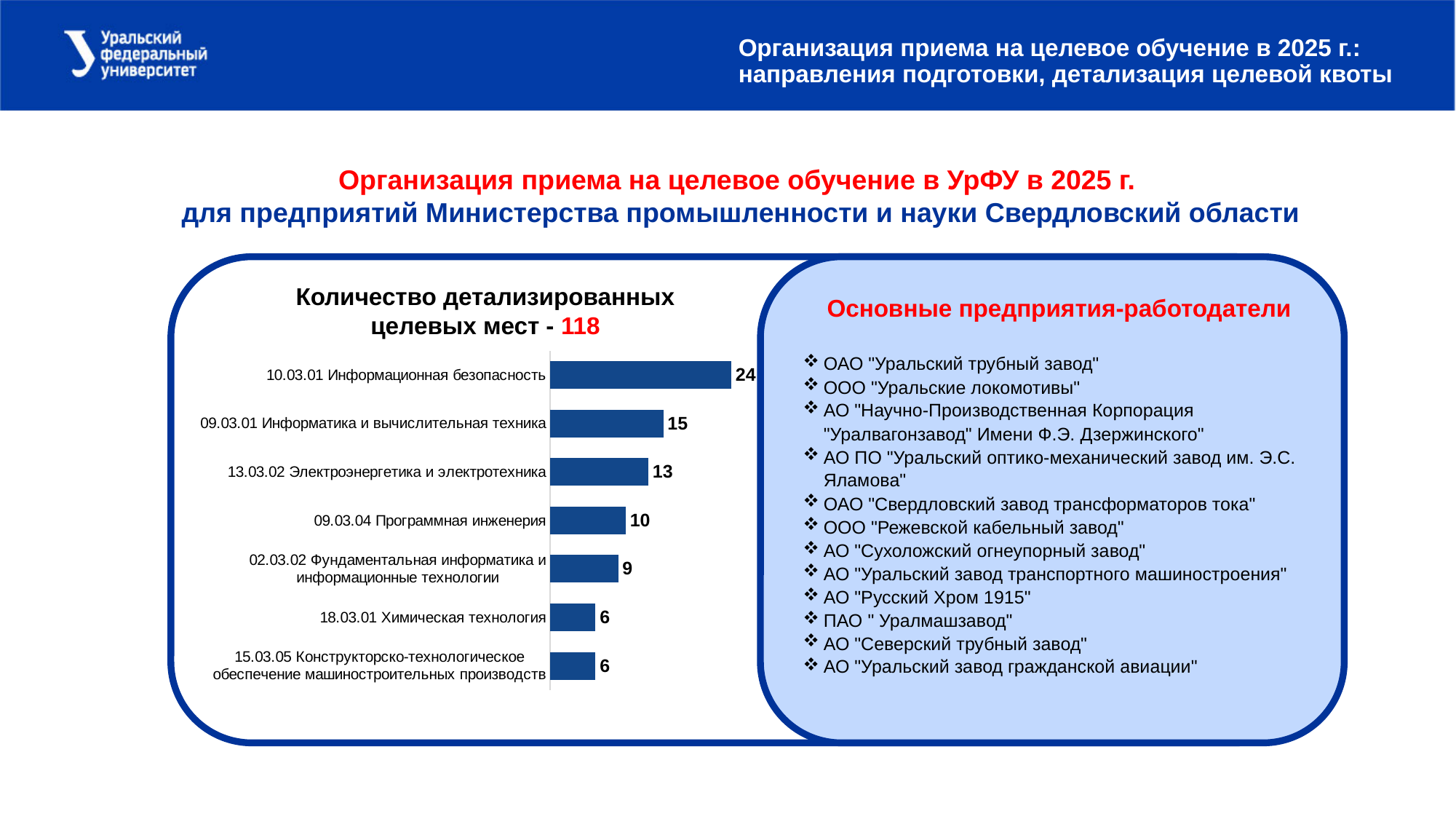
Which is larger: the value for 13.03.02 Электроэнергетика и электротехника or the value for 09.03.04 Программная инженерия? 13.03.02 Электроэнергетика и электротехника What is the value for 02.03.02 Фундаментальная информатика и информационные технологии? 9 What is the value for 18.03.01 Химическая технология? 6 What is the value for 09.03.01 Информатика и вычислительная техника? 15 What is the value for 10.03.01 Информационная безопасность? 24 What is the difference between the values for 10.03.01 Информационная безопасность and 09.03.01 Информатика и вычислительная техника? 9 What type of chart is shown on the slide? bar chart How many categories (programmes) are shown in the bar chart? 7 Which category has the highest value in the chart? 10.03.01 Информационная безопасность What is the value for 09.03.04 Программная инженерия? 10 What is the value for 13.03.02 Электроэнергетика и электротехника? 13 What total number of detailed target places is stated in the chart title? 118